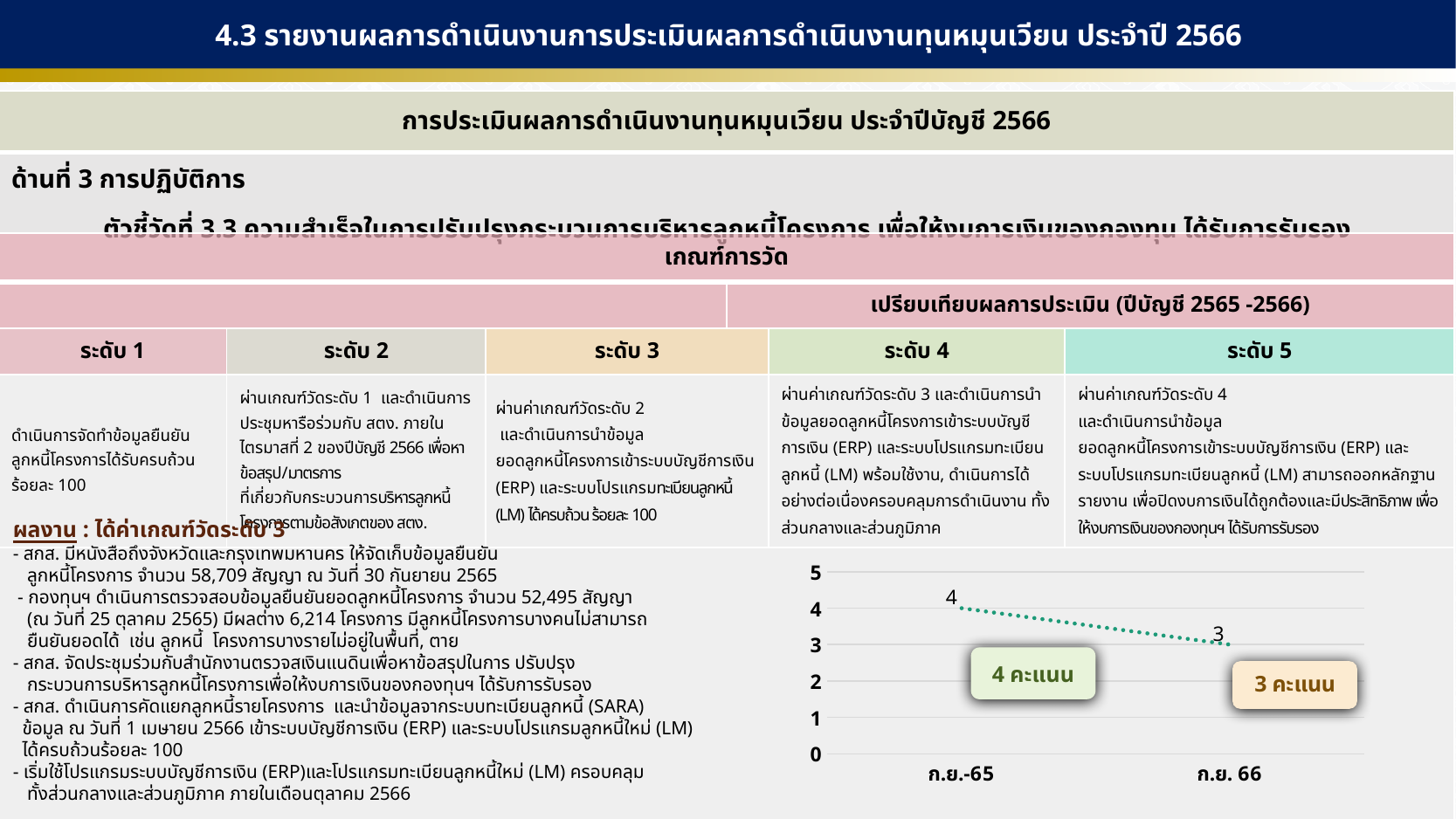
What kind of chart is shown on the slide? line chart Is the value for ก.ย.-65 greater or less than 3? greater Which category has the lowest value in the chart? ก.ย. 66 What text is shown in the callout box near the ก.ย. 66 point? 3 คะแนน Do the values rise or fall from ก.ย.-65 to ก.ย. 66? fall What is the value for ก.ย.-65 in the chart? 4 How many data points are plotted in the chart? 2 Which category has the highest value in the chart? ก.ย.-65 What is the difference between the values for ก.ย.-65 and ก.ย. 66? 1 What is the highest value shown on the chart's vertical axis? 5 Which is larger, the value for ก.ย.-65 or the value for ก.ย. 66? ก.ย.-65 What is the value for ก.ย. 66 in the chart? 3